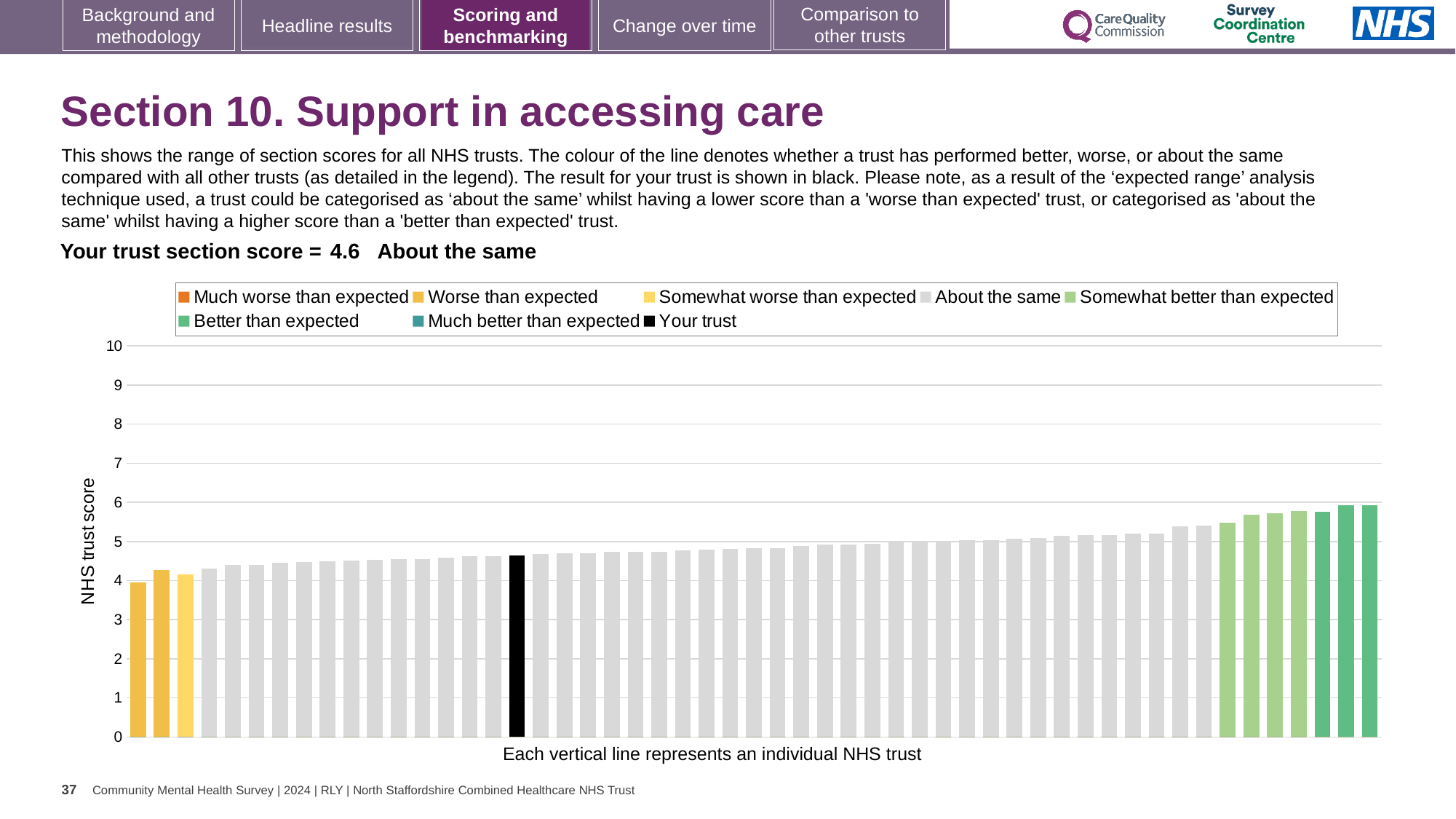
What is the section score for your trust shown on the slide? 4.6 Is the value of the shortest bar greater or less than 5? less Is the value of the tallest bar greater or less than 7? less Is the value of the tallest bar greater or less than 5? greater What is the label on the vertical axis of the chart? NHS trust score How many entries does the chart legend list? 8 What kind of chart is shown on the slide? bar chart How many bars at the left of the chart are coloured in the 'Worse than expected' colour? 2 How is your trust's section score categorised on the slide? About the same Do the bar values rise or fall from left to right along the x axis? rise What is the highest value shown on the vertical axis? 10